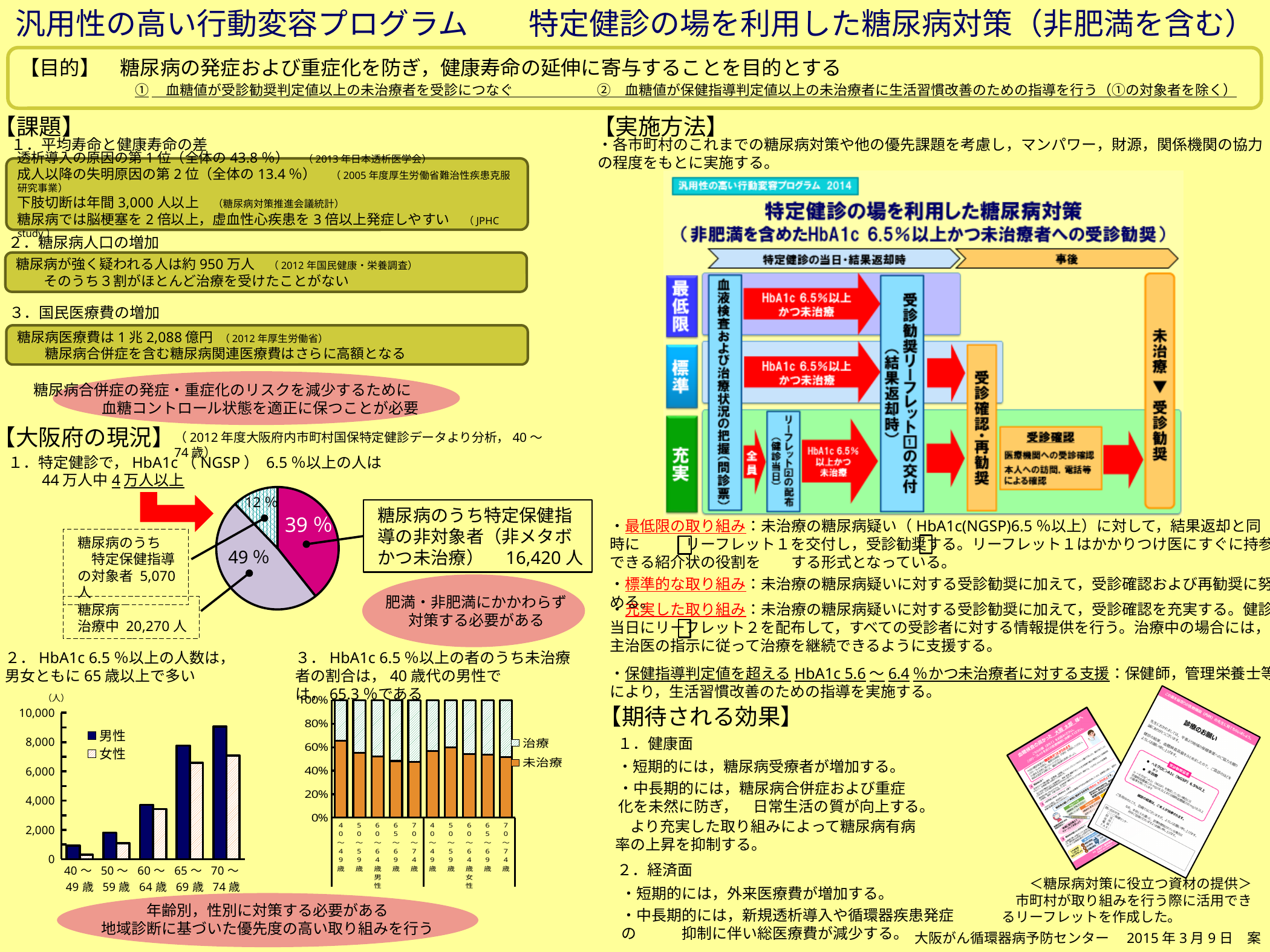
How many series does the legend of the stacked bar chart (治療/未治療) list? 2 In the pie chart on the left, what percentage is shown for the smallest slice? 12 % In the bottom-left bar chart (男性/女性), which age group has the highest value for 男性? 70～74歳 How many slices does the pie chart on the left have? 3 In the pie chart on the left, what is the difference in percentage points between the 49 % slice and the 39 % slice? 10 In the bottom-left bar chart (男性/女性), which is larger for the 65～69歳 group, 男性 or 女性? 男性 In the bottom-left bar chart (男性/女性), is the value for 女性 in the 40～49歳 group greater or less than 2,000? less What kind of chart is the chart at the bottom left showing 男性 and 女性 by age group? bar chart How many series does the legend of the bottom-left bar chart (男性/女性) list? 2 In the pie chart on the left, what percentage is shown for the largest slice? 49 % In the bottom-left bar chart (男性/女性), is the value for 男性 in the 70～74歳 group greater or less than 8,000? greater In the pie chart on the left, what percentage is shown for the magenta slice? 39 %